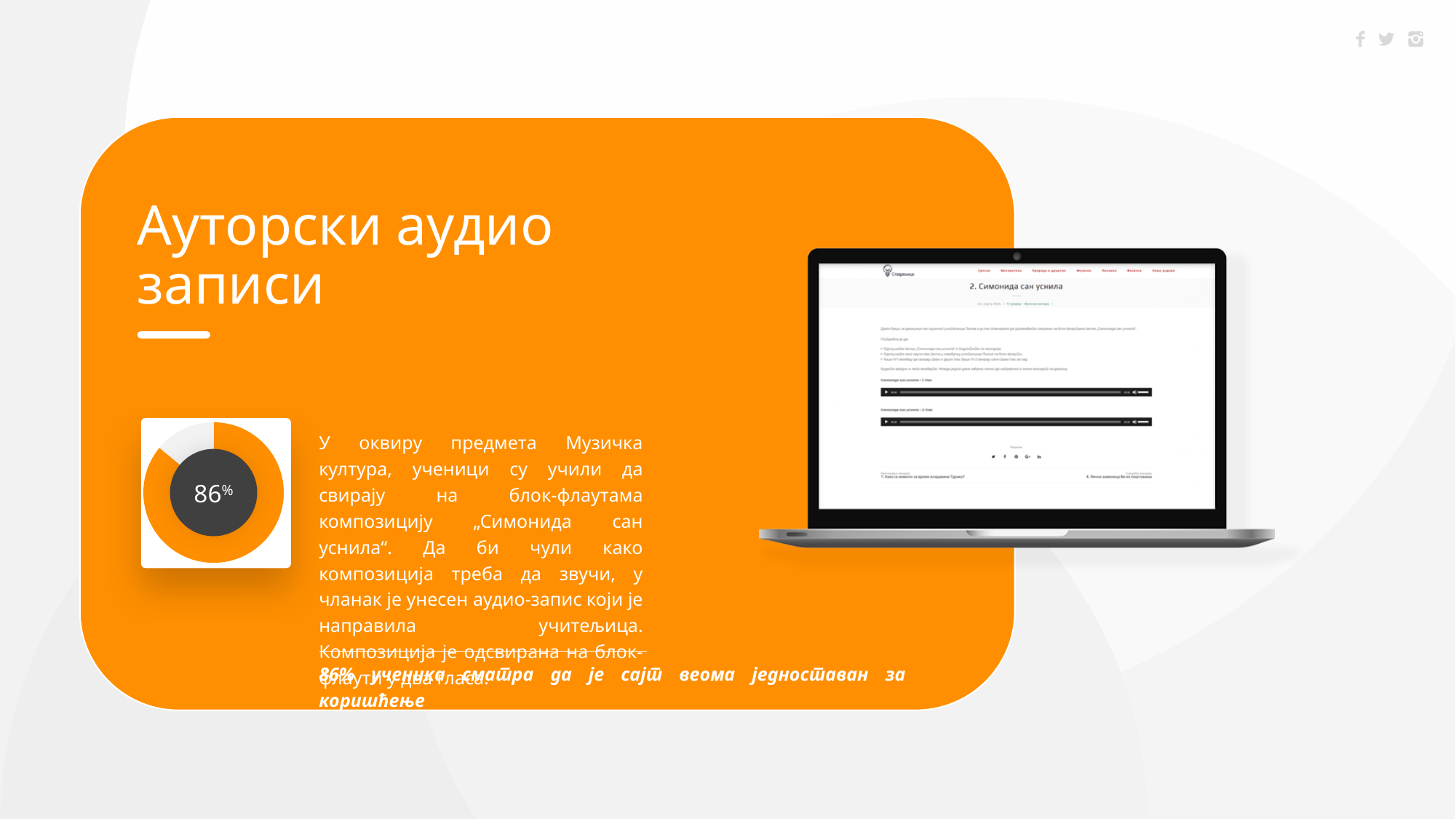
How many segments does the donut chart have? 2 What kind of chart is shown on the left of the slide? donut chart What percentage is shown in the centre of the donut chart? 86% Is the value shown in the donut chart greater or less than 90%? less What share of the donut chart is not filled by the orange segment? 14% What colour is the filled segment of the donut chart? orange Is the value shown in the donut chart greater or less than 50%? greater What colour is the centre circle of the donut chart that contains the value? dark grey